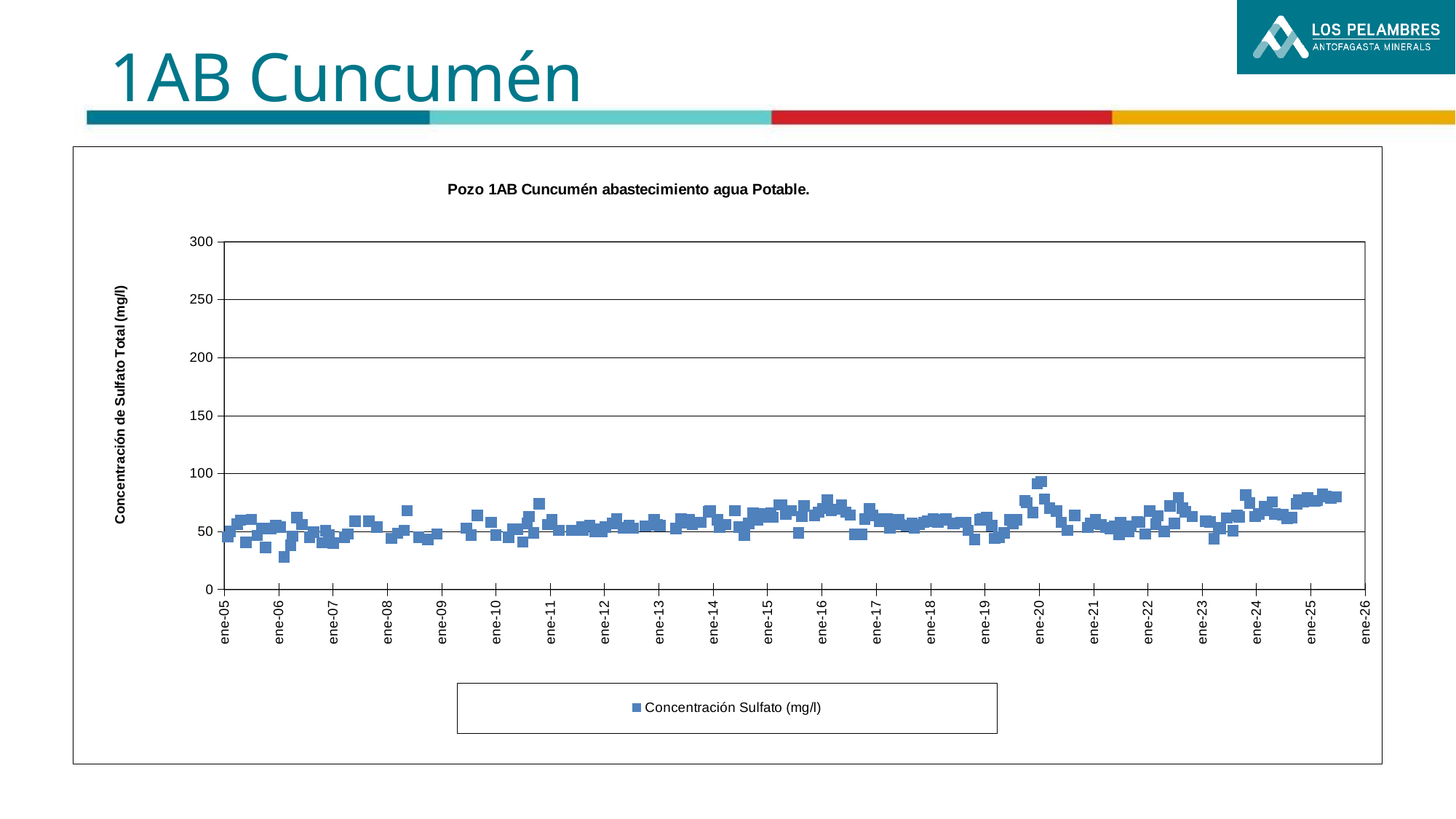
Is the highest plotted value on the chart greater or less than 150? less How many series does the legend list? 1 What is the maximum value shown on the y axis? 300 Is the highest plotted value, near ene-20, greater or less than 50? greater Is the value plotted at ene-05 greater or less than 100? less What is the title of the chart? Pozo 1AB Cuncumén abastecimiento agua Potable. Near which x-axis label does the highest point on the chart occur? ene-20 Near which x-axis label does the lowest point on the chart occur? ene-06 What is the name of the series shown in the legend? Concentración Sulfato (mg/l) How many labels are shown on the x axis? 22 What kind of chart is shown on the slide? scatter chart